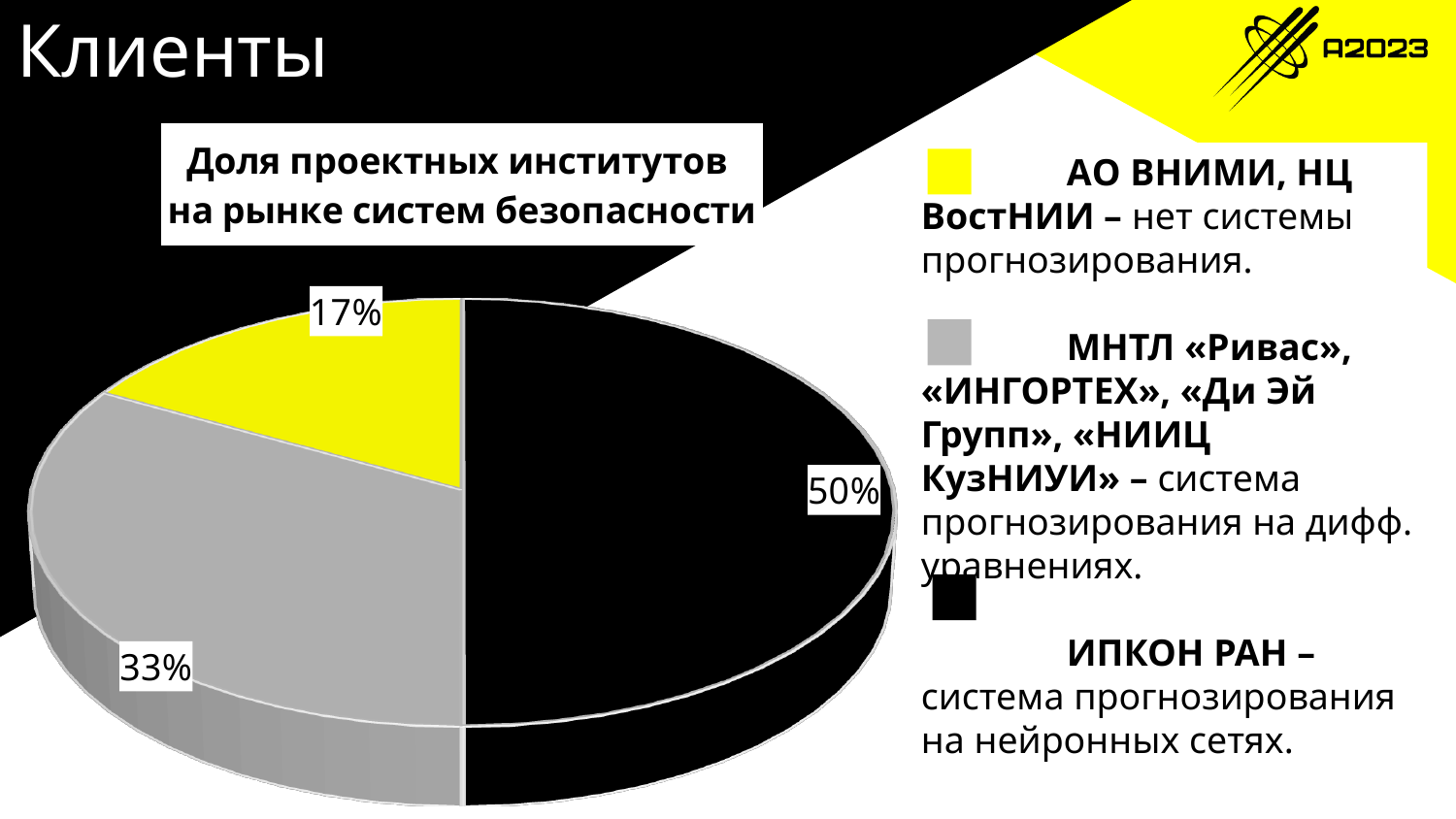
What share of the pie does the black slice (ИПКОН РАН) represent? 50% Which colour represents ИПКОН РАН in the pie chart? black What is the difference in percentage points between the gray slice and the yellow slice? 16 What is the title of the pie chart? Доля проектных институтов на рынке систем безопасности Which slice of the pie chart is the smallest? АО ВНИМИ, НЦ ВостНИИ (yellow, 17%) What kind of chart is shown on the slide? pie chart What is the difference in percentage points between the black slice and the gray slice? 17 How many slices does the pie chart have? 3 What share of the pie does the gray slice (МНТЛ «Ривас», «ИНГОРТЕХ», «Ди Эй Групп», «НИИЦ КузНИУИ») represent? 33% What share of the pie does the yellow slice (АО ВНИМИ, НЦ ВостНИИ) represent? 17% Which is larger: the gray slice or the yellow slice? the gray slice Which slice of the pie chart is the largest? ИПКОН РАН (black, 50%)